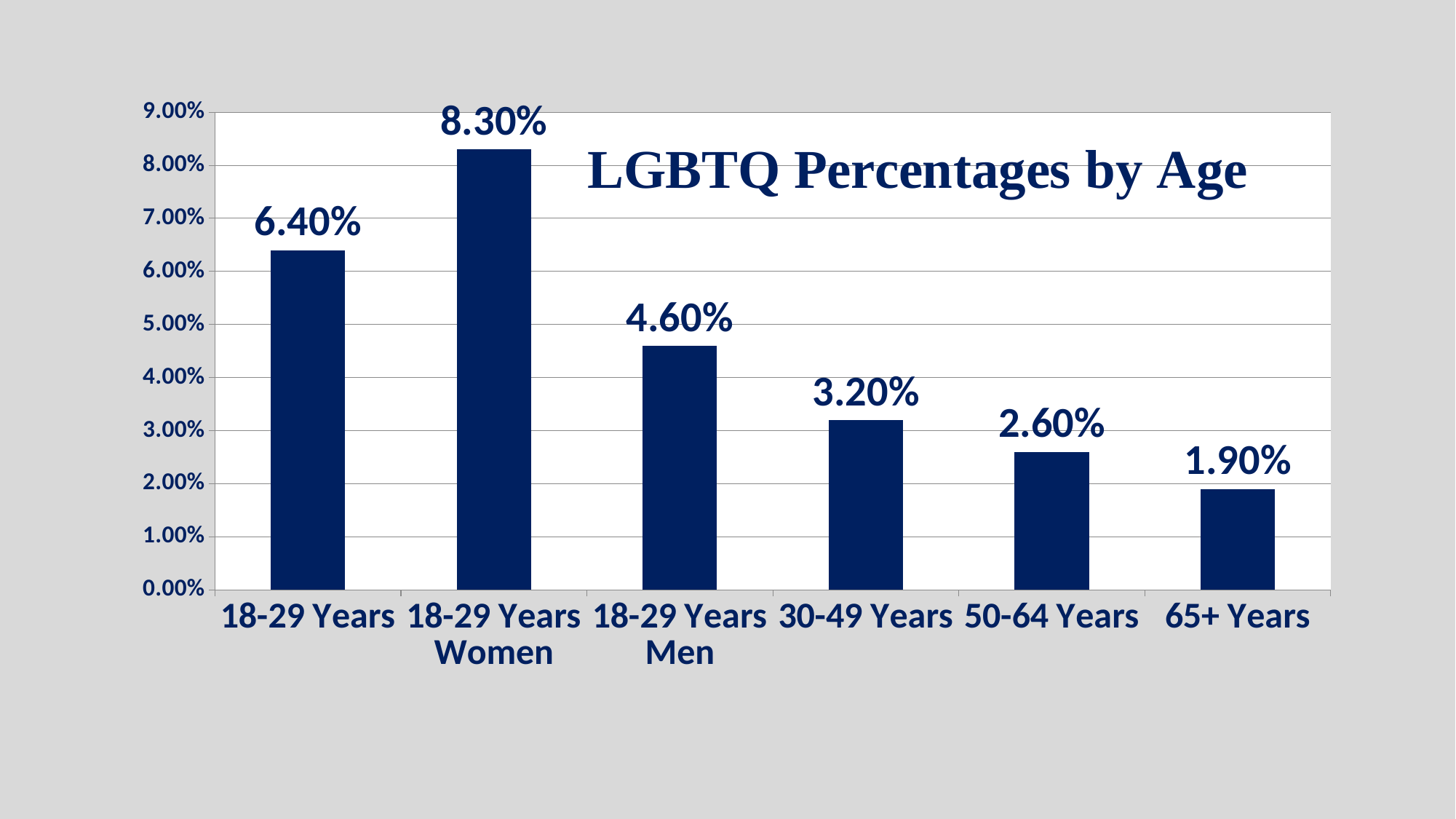
How many categories are shown on the x axis? 6 Which is larger, the value for 50-64 Years or the value for 30-49 Years? 30-49 Years What kind of chart is shown on the slide? bar chart Is the value for 18-29 Years greater or less than 6.00%? greater Which category has the lowest value? 65+ Years Which category has the highest value? 18-29 Years Women Do the values rise or fall from 18-29 Years Women to 65+ Years along the x axis? fall What is the title of the chart? LGBTQ Percentages by Age What is the value for 30-49 Years? 3.20% What is the value for 65+ Years? 1.90% What is the difference between the values for 18-29 Years Women and 18-29 Years Men? 3.70% What is the value for 18-29 Years Women? 8.30%